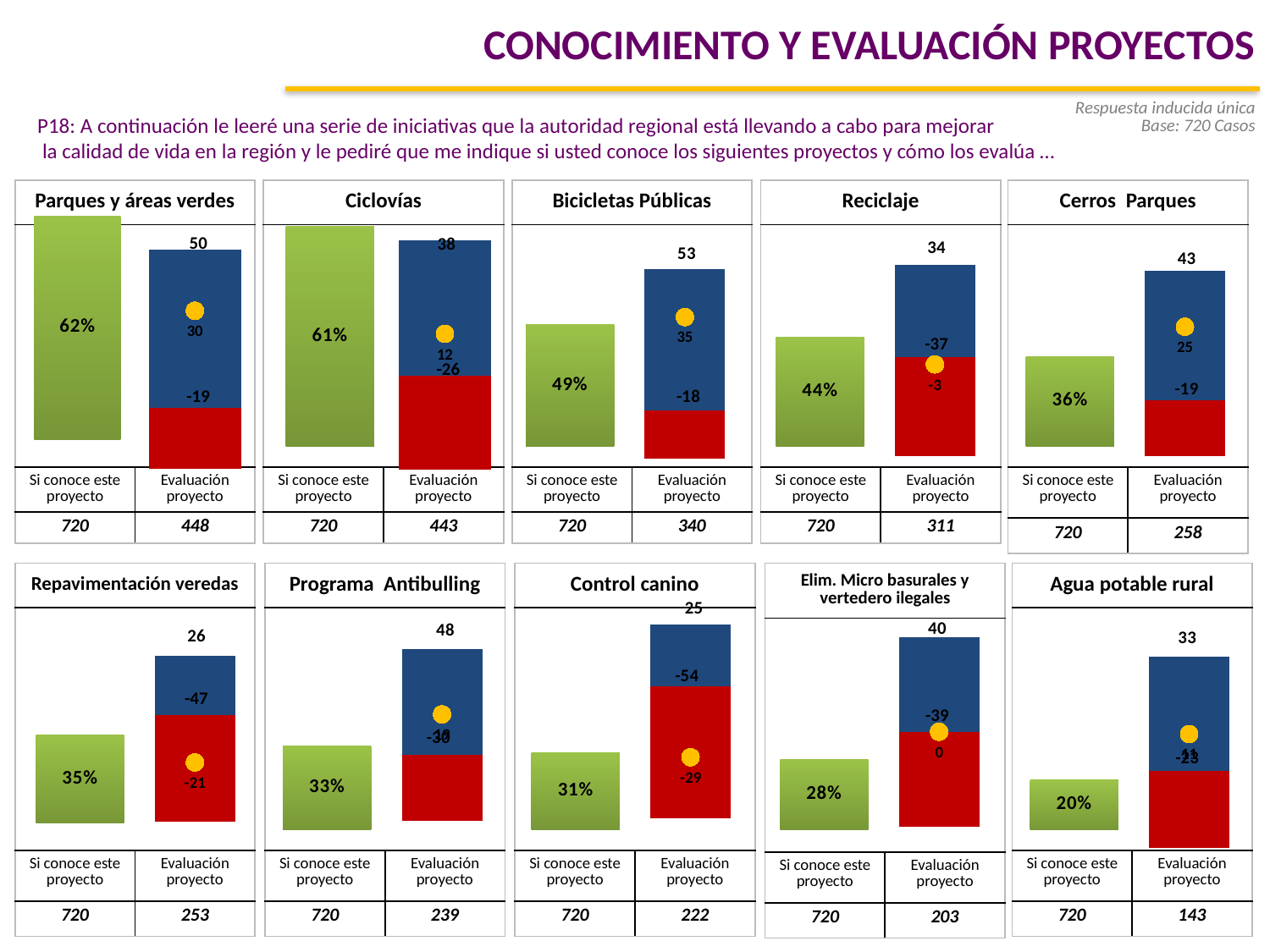
What type of chart is used for each project on the slide? Bar chart In the 'Reciclaje' chart, what is the value of the red (negative) segment of the 'Evaluación proyecto' bar? -37 In the 'Repavimentación veredas' chart, what is the value of the red (negative) segment of the 'Evaluación proyecto' bar? -47 Across all ten charts, which project has the highest 'Si conoce este proyecto' percentage? Parques y áreas verdes How many project charts are shown on the slide? 10 In the 'Control canino' chart, what value is shown next to the yellow dot on the 'Evaluación proyecto' bar? -29 Which is larger: the 'Si conoce este proyecto' percentage for 'Ciclovías' or for 'Cerros Parques'? Ciclovías What is the difference between the 'Si conoce este proyecto' percentages for 'Bicicletas Públicas' and 'Reciclaje'? 5 percentage points In the 'Elim. Micro basurales y vertedero ilegales' chart, what is the base number shown under 'Evaluación proyecto'? 203 Across all ten charts, which project has the lowest 'Si conoce este proyecto' percentage? Agua potable rural In the 'Bicicletas Públicas' chart, what is the value of the blue (positive) segment of the 'Evaluación proyecto' bar? 53 In the 'Parques y áreas verdes' chart, what percentage is shown for 'Si conoce este proyecto'? 62%